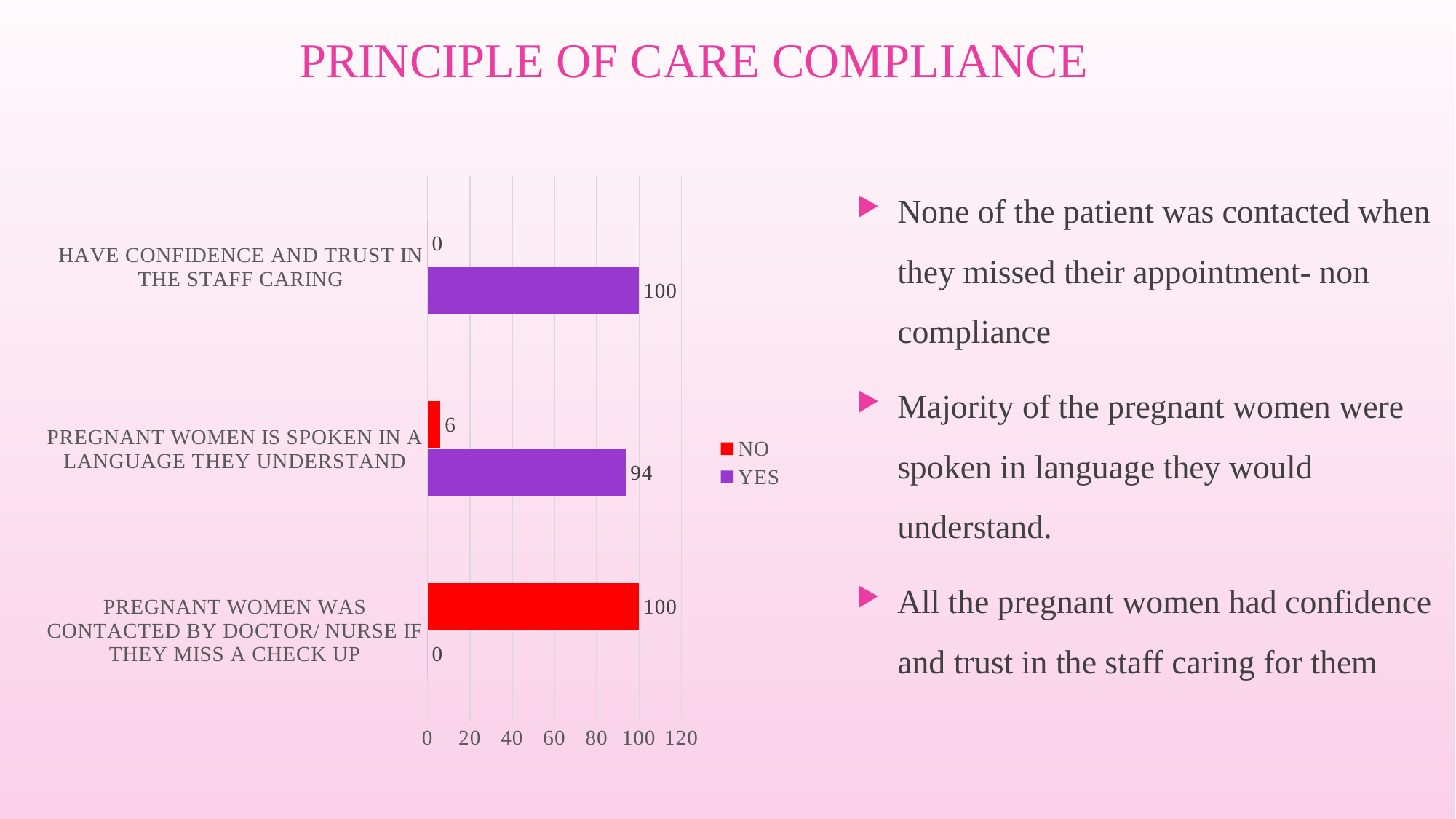
Which category has the highest NO value? Pregnant women was contacted by doctor/ nurse if they miss a check up What is the NO value for 'Pregnant women is spoken in a language they understand'? 6 What is the YES value for 'Pregnant women is spoken in a language they understand'? 94 What is the YES value for 'Pregnant women was contacted by doctor/ nurse if they miss a check up'? 0 How many categories are shown on the chart? 3 What is the YES value for 'Have confidence and trust in the staff caring'? 100 How many series does the legend list? 2 For 'Pregnant women is spoken in a language they understand', which is larger, YES or NO? YES What kind of chart is shown on the slide? Bar chart What is the difference between the YES and NO values for 'Pregnant women is spoken in a language they understand'? 88 Which category has the lowest YES value? Pregnant women was contacted by doctor/ nurse if they miss a check up What is the NO value for 'Pregnant women was contacted by doctor/ nurse if they miss a check up'? 100